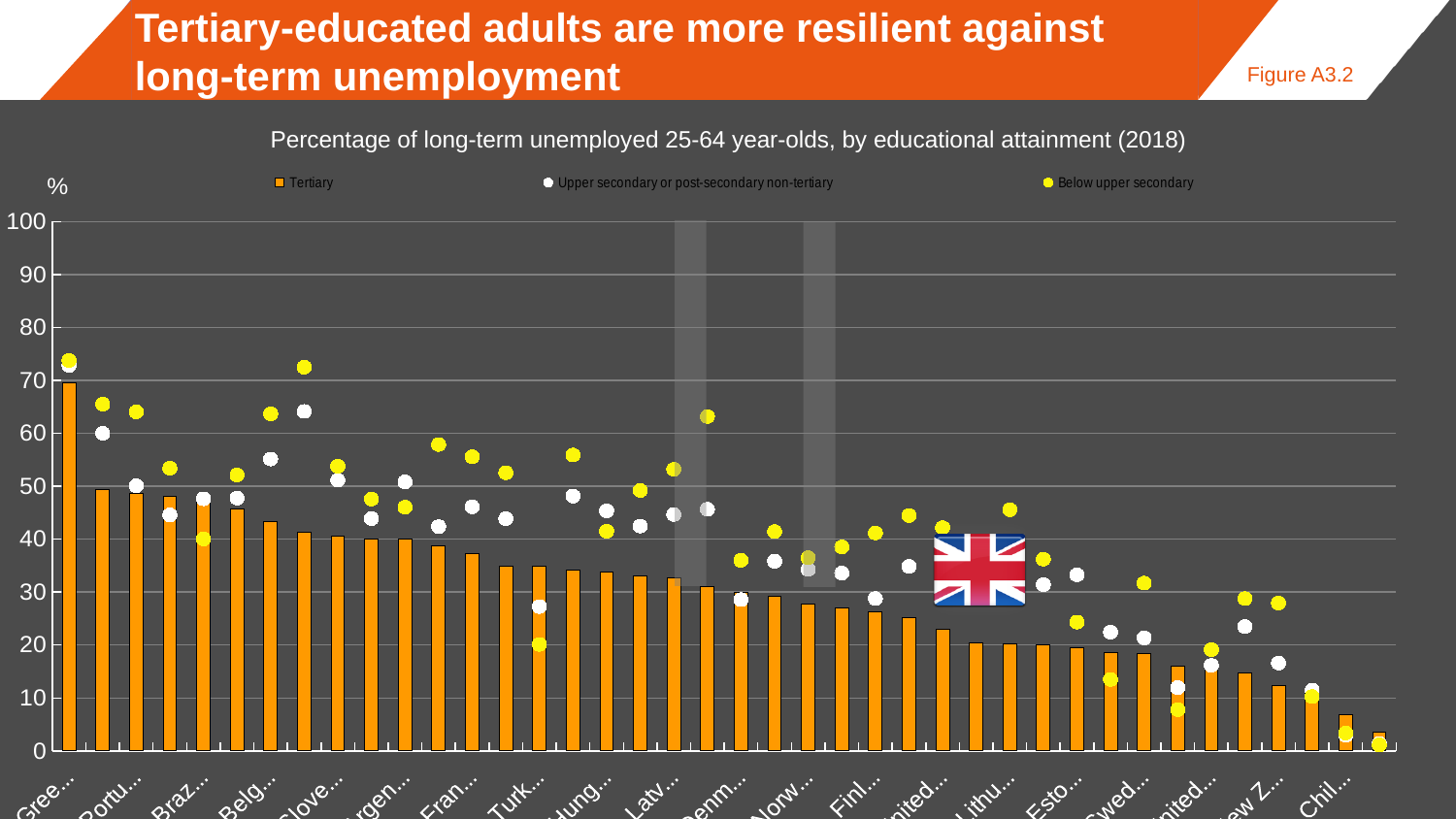
For the leftmost category, is the Tertiary value larger or smaller than the Below upper secondary value? smaller What kind of chart is shown on the slide? bar chart What are the three series named in the legend? Tertiary; Upper secondary or post-secondary non-tertiary; Below upper secondary Which series has the highest value for the leftmost category: Tertiary or Upper secondary or post-secondary non-tertiary? Upper secondary or post-secondary non-tertiary Do the Tertiary bars rise or fall from left to right along the x axis? fall How many series does the legend list? 3 What is the highest value shown on the vertical axis? 100 What is the chart's subtitle describing the data? Percentage of long-term unemployed 25-64 year-olds, by educational attainment (2018) Is the Tertiary value for the rightmost category greater or less than 10? less Is the Tertiary value for the leftmost category greater or less than 60? greater